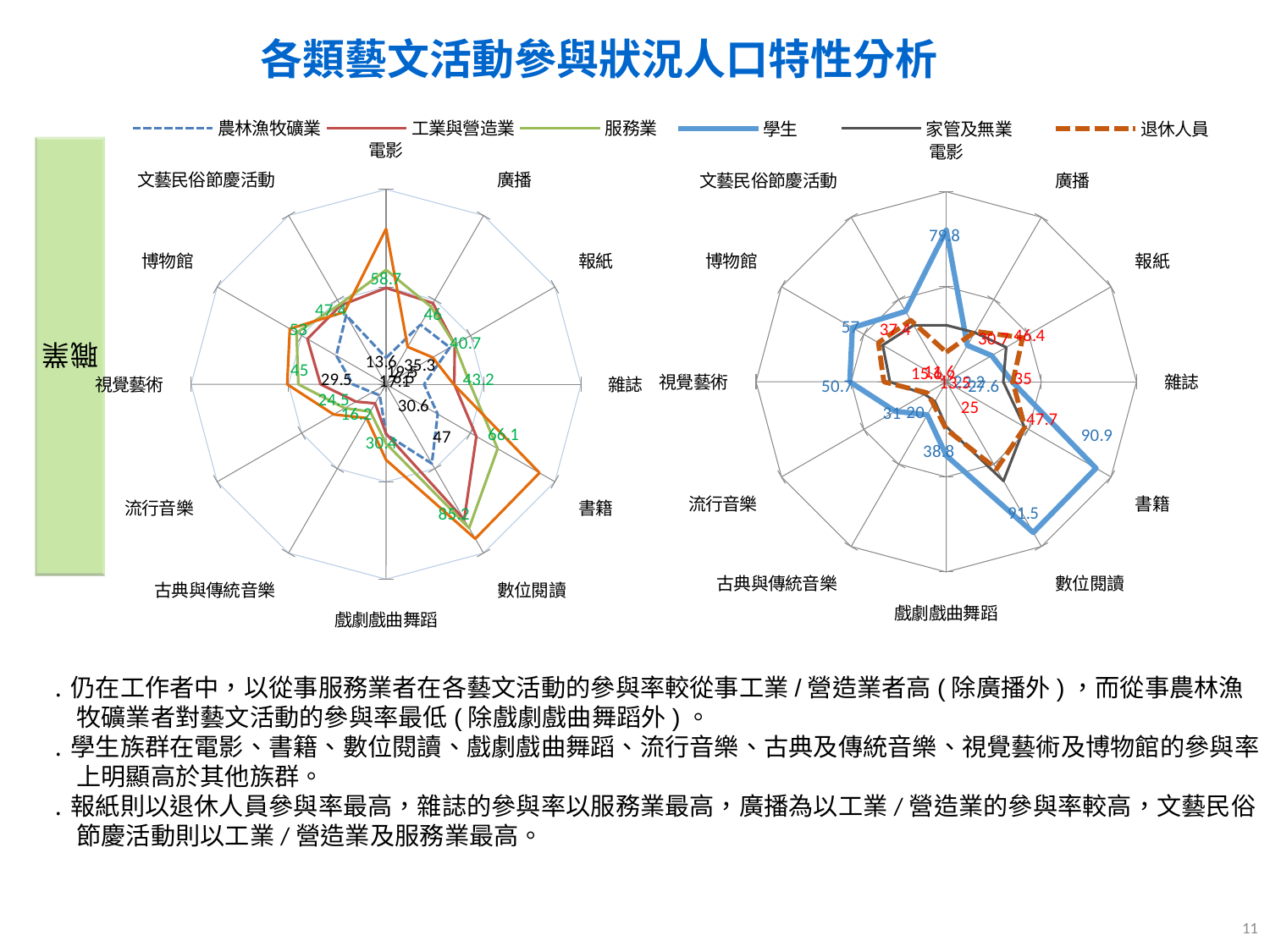
In the left chart, what is the value for 服務業 on 數位閱讀? 85.2 How many series does the legend list? 6 In the left chart, which is larger for 服務業: 書籍 or 數位閱讀? 數位閱讀 How many activity categories (axes) does the left radar chart have? 12 What type of chart is used on this slide? Radar chart In the right chart, what is the value for 學生 on 書籍? 90.9 In the right chart, what is the value for 學生 on 數位閱讀? 91.5 In the right chart, which category has the highest value for 學生? 數位閱讀 In the right chart, what is the difference between the 學生 values for 數位閱讀 and 電影? 11.7 In the right chart, what is the value for 退休人員 on 報紙? 46.4 In the left chart, what is the value for 服務業 on 電影? 58.7 In the right chart, what is the value for 學生 on 電影? 79.8